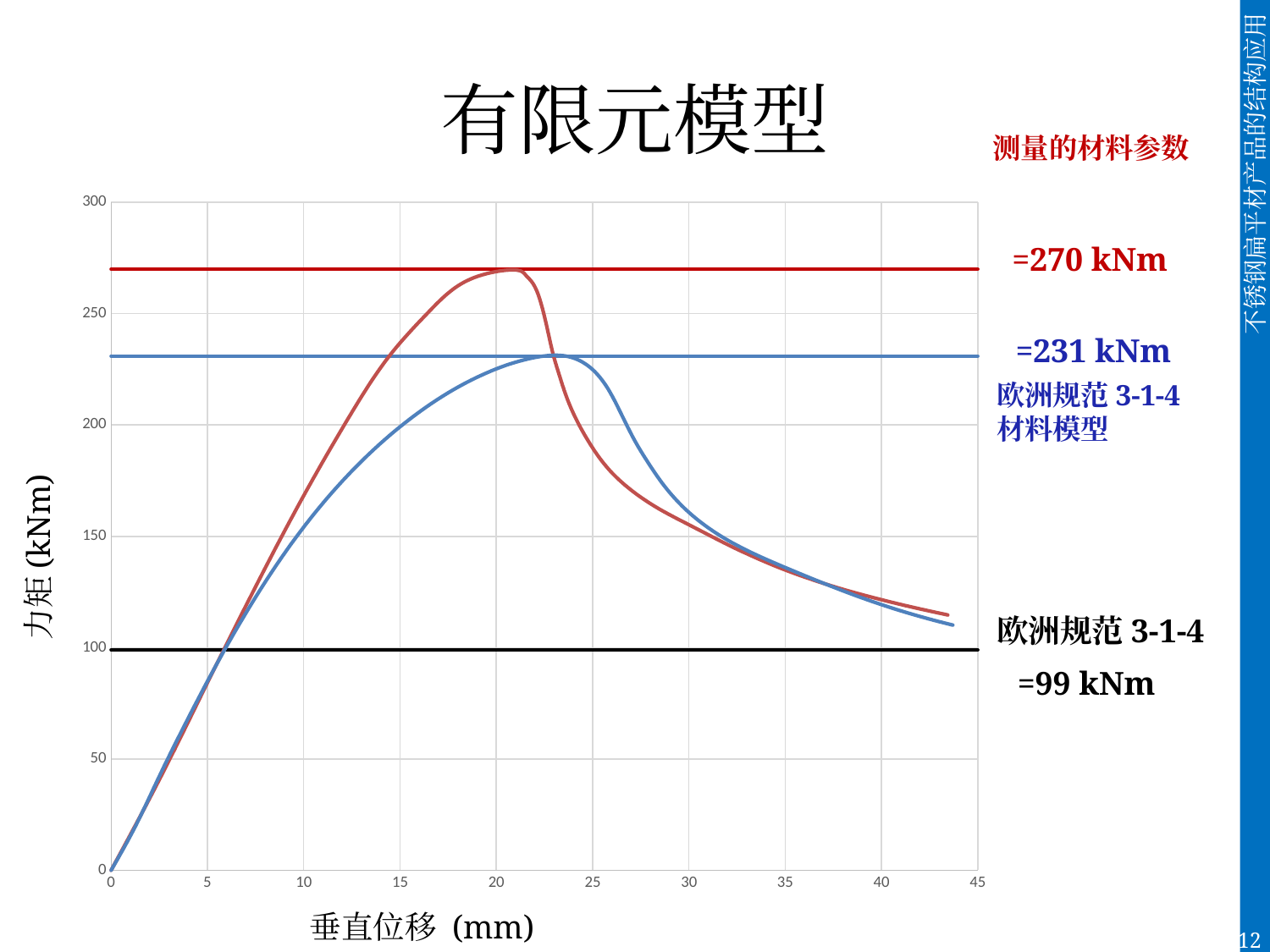
What is the difference between the 270 kNm and 231 kNm values marked on the chart? 39 kNm What is the label of the vertical axis of the chart? 力矩 (kNm) Which curve reaches a higher peak moment, the red curve or the blue curve? the red curve What moment value is marked by the black horizontal line labelled 欧洲规范 3-1-4? 99 kNm What is the label of the horizontal axis of the chart? 垂直位移 (mm) What kind of chart is shown on the slide? line chart Is the value of the blue curve at a vertical displacement of 40 mm greater or less than 150 kNm? less What is the difference between the 231 kNm and 99 kNm values marked on the chart? 132 kNm What peak moment value is marked by the blue horizontal line for the Eurocode 3-1-4 material model (欧洲规范 3-1-4 材料模型)? 231 kNm How does the moment change along the x axis for the red curve: does it rise steadily, fall steadily, or rise and then fall? rise and then fall What peak moment value is marked by the red horizontal line for the measured material parameters (测量的材料参数)? 270 kNm Is the value of the red curve at a vertical displacement of 20 mm greater or less than 250 kNm? greater